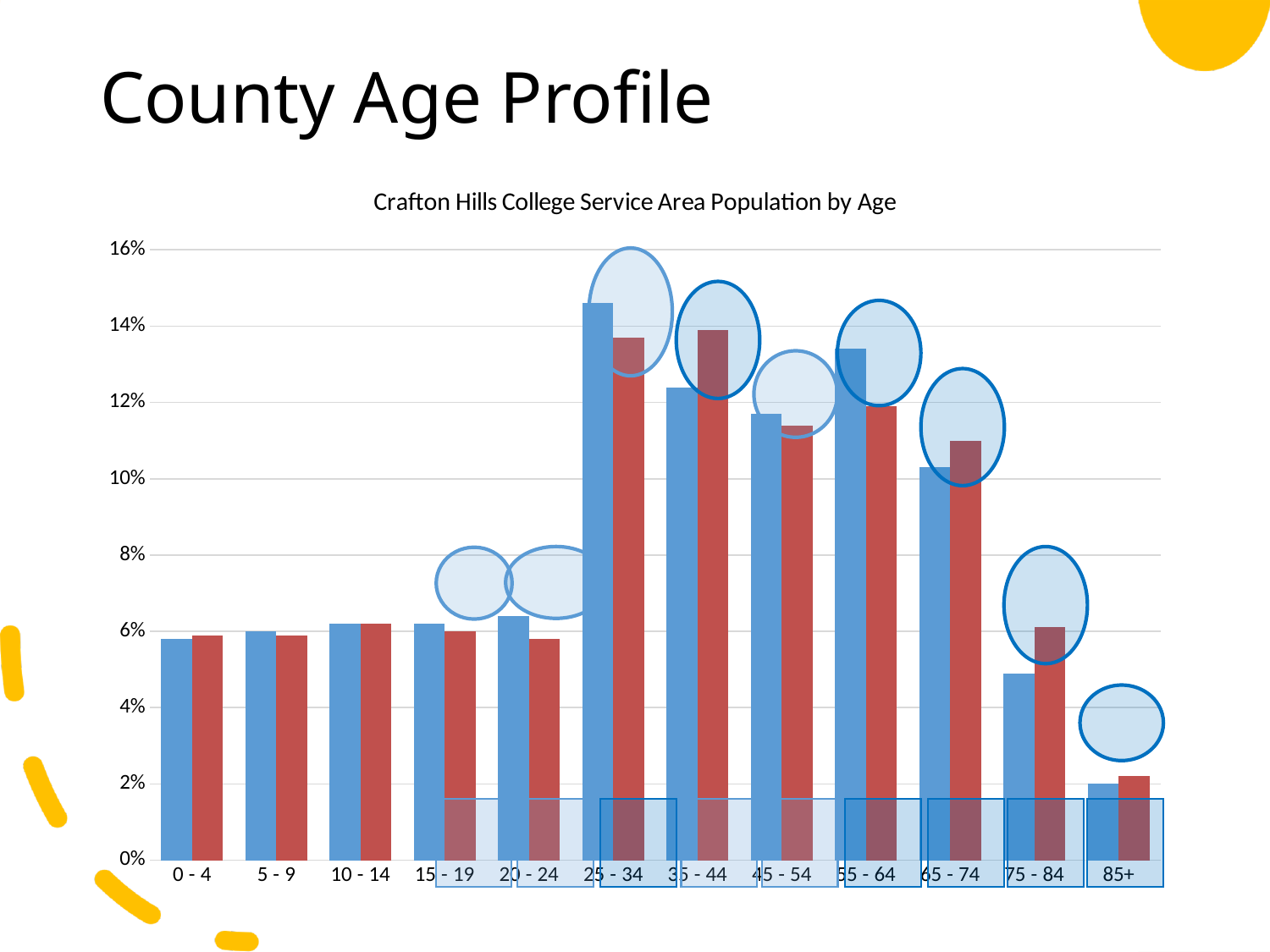
Is the red bar for 45 - 54 greater or less than 12%? less How many age groups are shown on the x axis? 12 How many bars are plotted for each age group? 2 Which age group has the shortest blue bar? 85+ Which age group has the tallest red bar? 35 - 44 Is the blue bar for 75 - 84 greater or less than 4%? greater Is the blue bar for 25 - 34 greater or less than 14%? greater What kind of chart is shown on the slide? bar chart For the 35 - 44 age group, which bar is taller, the blue or the red? red Which age group has the tallest blue bar? 25 - 34 What is the title of the chart? Crafton Hills College Service Area Population by Age